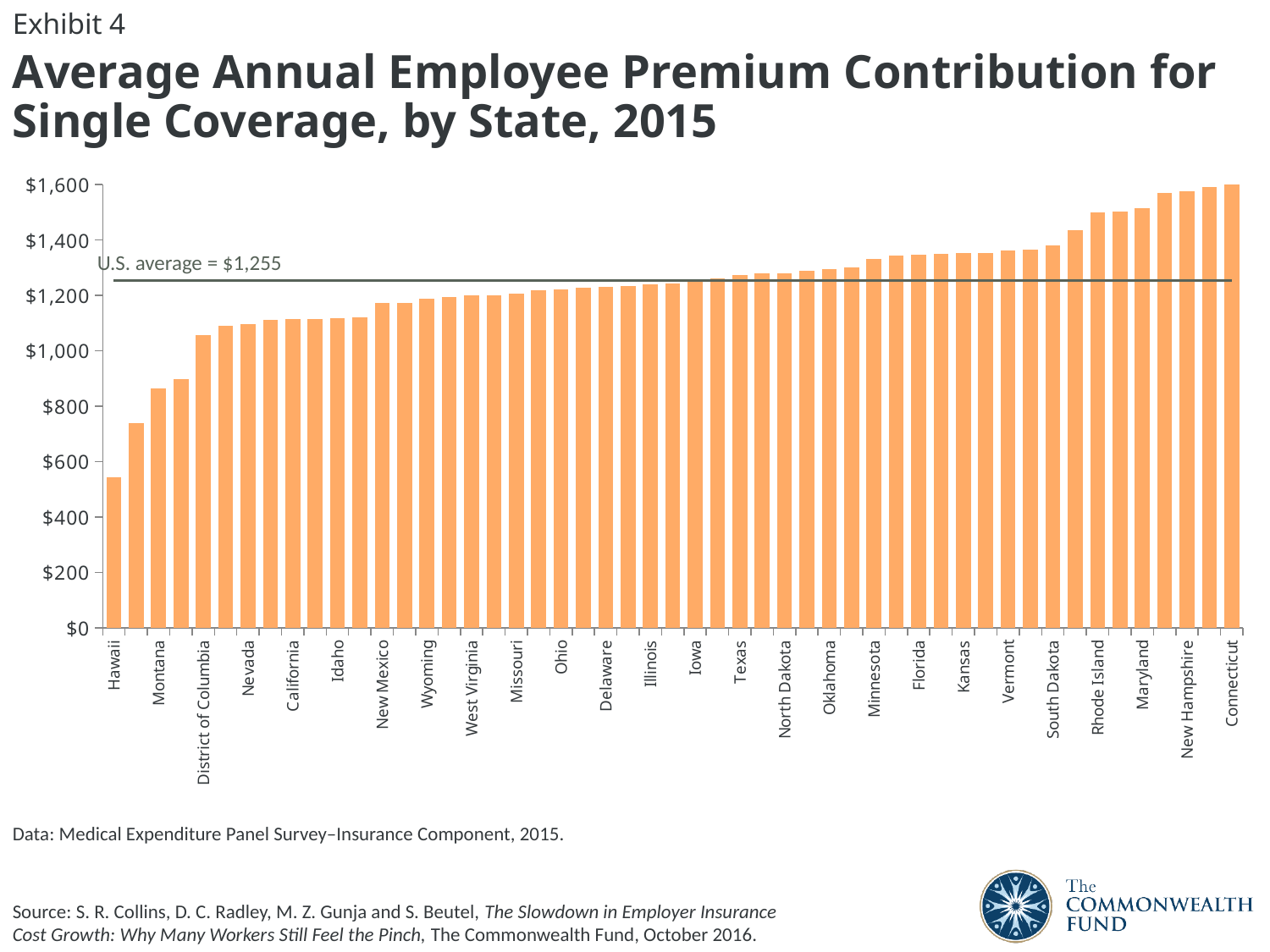
Which is larger, the value for Hawaii or the value for Montana? Montana Do the bar values rise or fall from left to right across the chart? rise Is the value for Rhode Island greater or less than $1,400? greater Is the value for Hawaii greater or less than $600? less Is the value for Nevada greater or less than $1,000? greater What is the U.S. average shown by the horizontal line on the chart? $1,255 What is the title of the chart? Average Annual Employee Premium Contribution for Single Coverage, by State, 2015 Which state has the highest average annual employee premium contribution? Connecticut Which state has the lowest average annual employee premium contribution? Hawaii What kind of chart is shown on the slide? bar chart